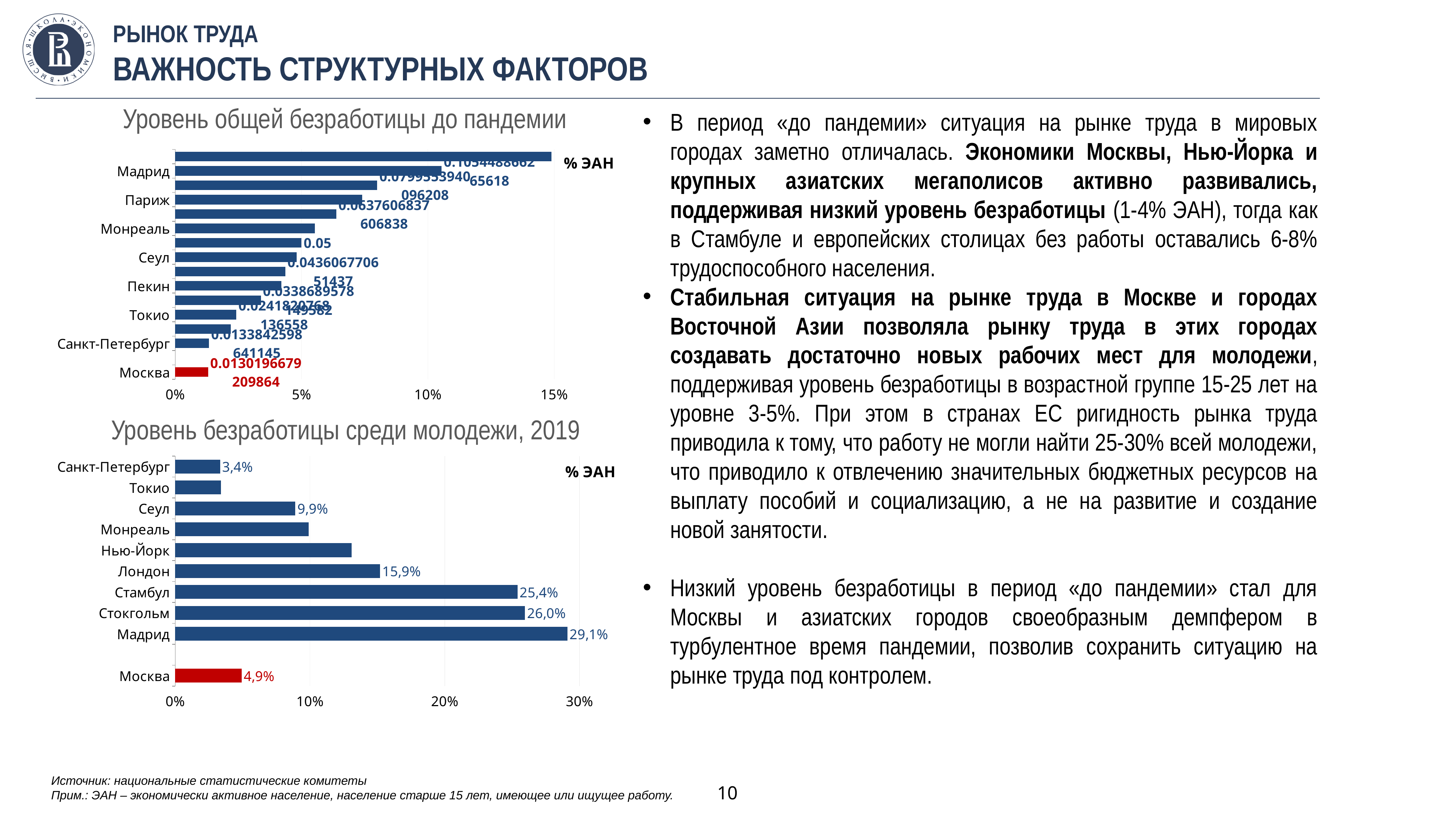
In the chart 'Уровень безработицы среди молодежи, 2019', what is the value for Мадрид? 29,1% In the chart 'Уровень безработицы среди молодежи, 2019', which city has the highest youth unemployment rate? Мадрид How many cities are shown in the chart 'Уровень безработицы среди молодежи, 2019'? 10 What kind of chart is 'Уровень безработицы среди молодежи, 2019'? bar chart In the chart 'Уровень безработицы среди молодежи, 2019', which is larger, Стокгольм or Стамбул? Стокгольм In the chart 'Уровень безработицы среди молодежи, 2019', what is the value for Москва? 4,9% In the chart 'Уровень безработицы среди молодежи, 2019', what is the value for Стамбул? 25,4% In the chart 'Уровень безработицы среди молодежи, 2019', is the value for Нью-Йорк greater or less than 10%? greater In the chart 'Уровень безработицы среди молодежи, 2019', what is the difference between Мадрид and Москва? 24,2% In the top chart 'Уровень общей безработицы до пандемии', is the value for Москва greater or less than 5%? less In the chart 'Уровень безработицы среди молодежи, 2019', is the value for Токио greater or less than 10%? less In the chart 'Уровень безработицы среди молодежи, 2019', what colour is the bar for Москва? red